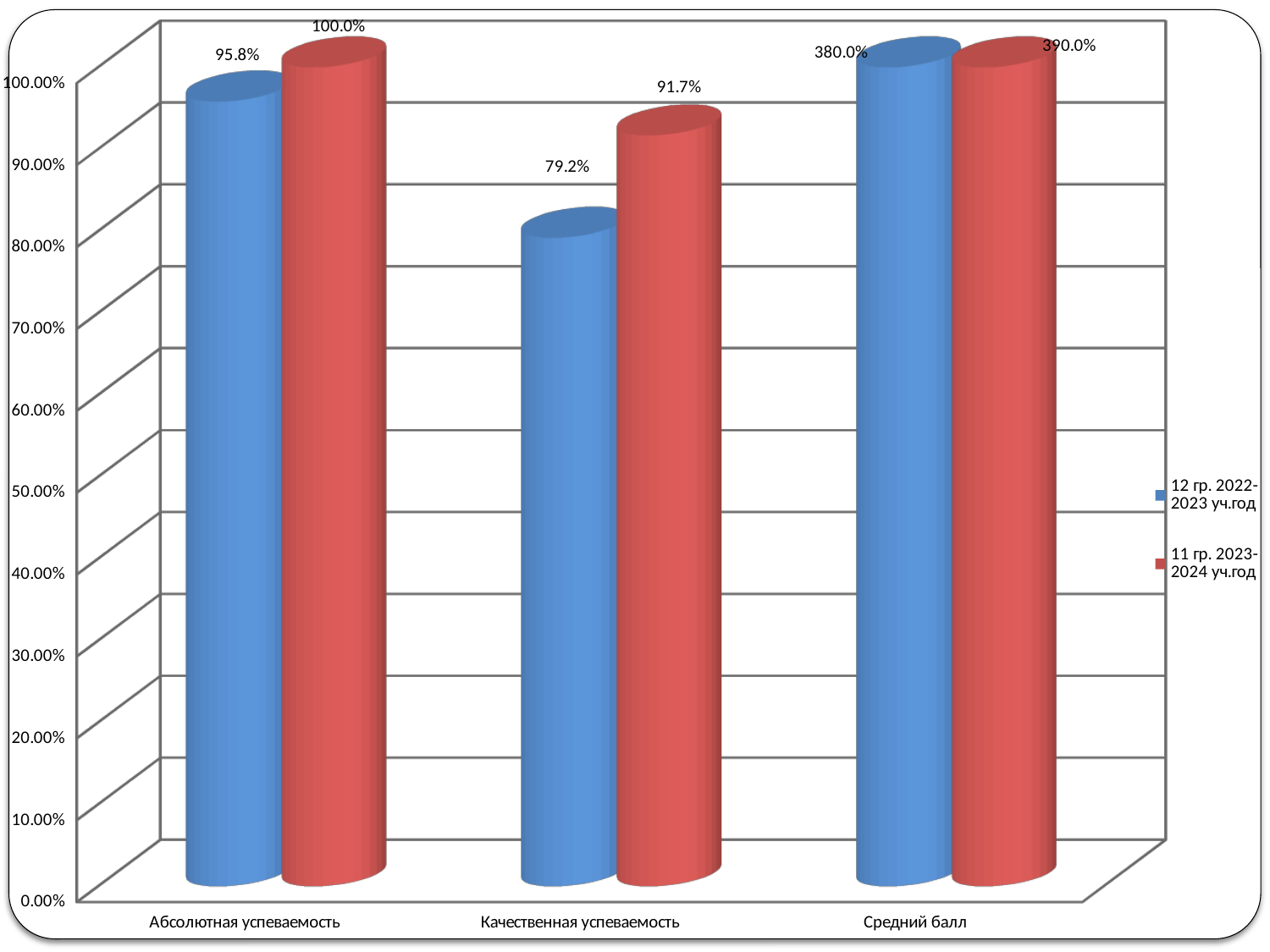
What is the value for 11 гр. 2023-2024 уч.год in the Качественная успеваемость category? 91.7% How many categories are shown on the x axis? 3 What colour are the bars for the 11 гр. 2023-2024 уч.год series? Red What kind of chart is shown on the slide? Bar chart What is the value for 11 гр. 2023-2024 уч.год in the Абсолютная успеваемость category? 100.0% What is the value for 12 гр. 2022-2023 уч.год in the Средний балл category? 380.0% Which category has the highest value for 11 гр. 2023-2024 уч.год? Средний балл How many series does the legend list? 2 What is the value for 12 гр. 2022-2023 уч.год in the Абсолютная успеваемость category? 95.8% Which category has the lowest value for 12 гр. 2022-2023 уч.год? Качественная успеваемость What is the difference between the 11 гр. 2023-2024 уч.год and 12 гр. 2022-2023 уч.год values in the Качественная успеваемость category? 12.5% In the Абсолютная успеваемость category, which series has the larger value? 11 гр. 2023-2024 уч.год